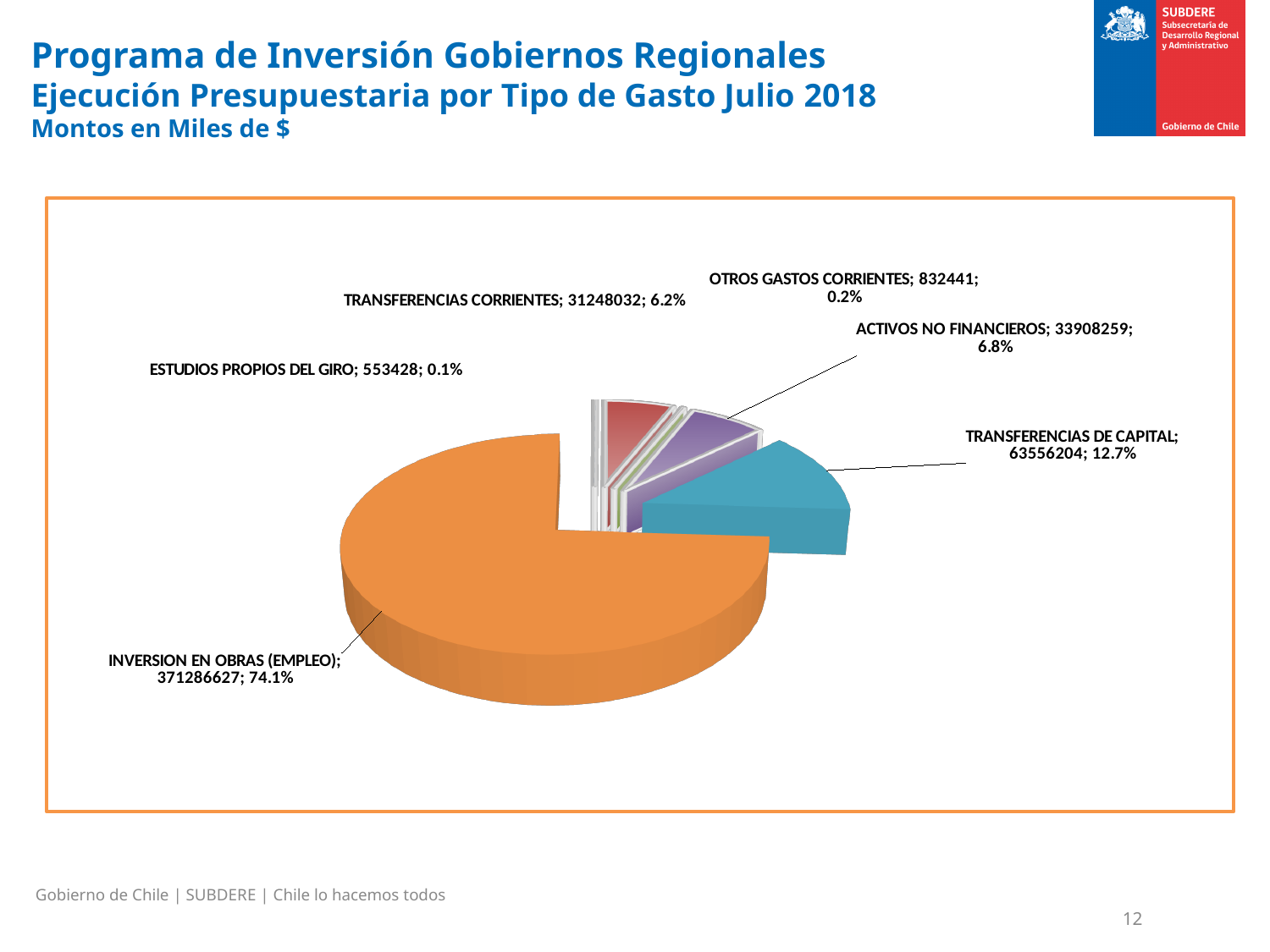
Which category has the largest slice of the pie? INVERSION EN OBRAS (EMPLEO) What type of chart is shown on the slide? Pie chart What share of the pie does TRANSFERENCIAS CORRIENTES represent? 6.2% What is the value for TRANSFERENCIAS DE CAPITAL? 63556204 What share of the pie does ESTUDIOS PROPIOS DEL GIRO represent? 0.1% Which is larger, the value for ACTIVOS NO FINANCIEROS or the value for TRANSFERENCIAS CORRIENTES? ACTIVOS NO FINANCIEROS How many categories does the pie chart show? 6 What is the value for INVERSION EN OBRAS (EMPLEO)? 371286627 What is the value for OTROS GASTOS CORRIENTES? 832441 Which category has the smallest slice of the pie? ESTUDIOS PROPIOS DEL GIRO What is the value for ACTIVOS NO FINANCIEROS? 33908259 What is the difference between the values for TRANSFERENCIAS DE CAPITAL and ACTIVOS NO FINANCIEROS? 29647945